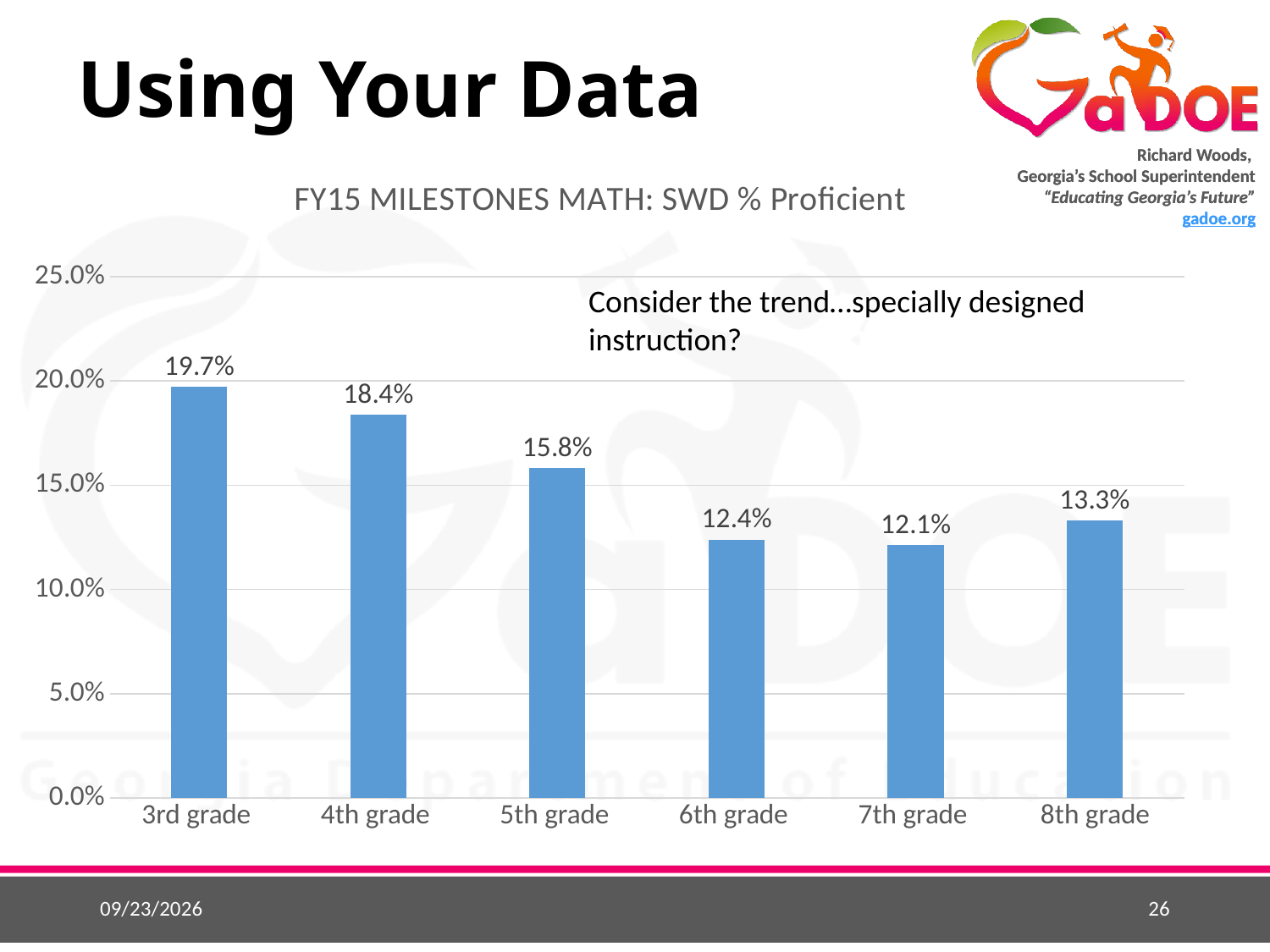
What is the difference between the 3rd grade and 8th grade values? 6.4% Which grade has the highest SWD % Proficient? 3rd grade What kind of chart is shown on the slide? bar chart What is the SWD % Proficient value for 6th grade? 12.4% What is the difference between the 4th grade and 5th grade values? 2.6% How many grade categories are shown on the chart? 6 Which is larger, the value for 5th grade or the value for 8th grade? 5th grade What is the title of the chart? FY15 MILESTONES MATH: SWD % Proficient Is the value for 4th grade greater or less than 15.0%? greater What is the SWD % Proficient value for 8th grade? 13.3% Which grade has the lowest SWD % Proficient? 7th grade What is the SWD % Proficient value for 3rd grade? 19.7%